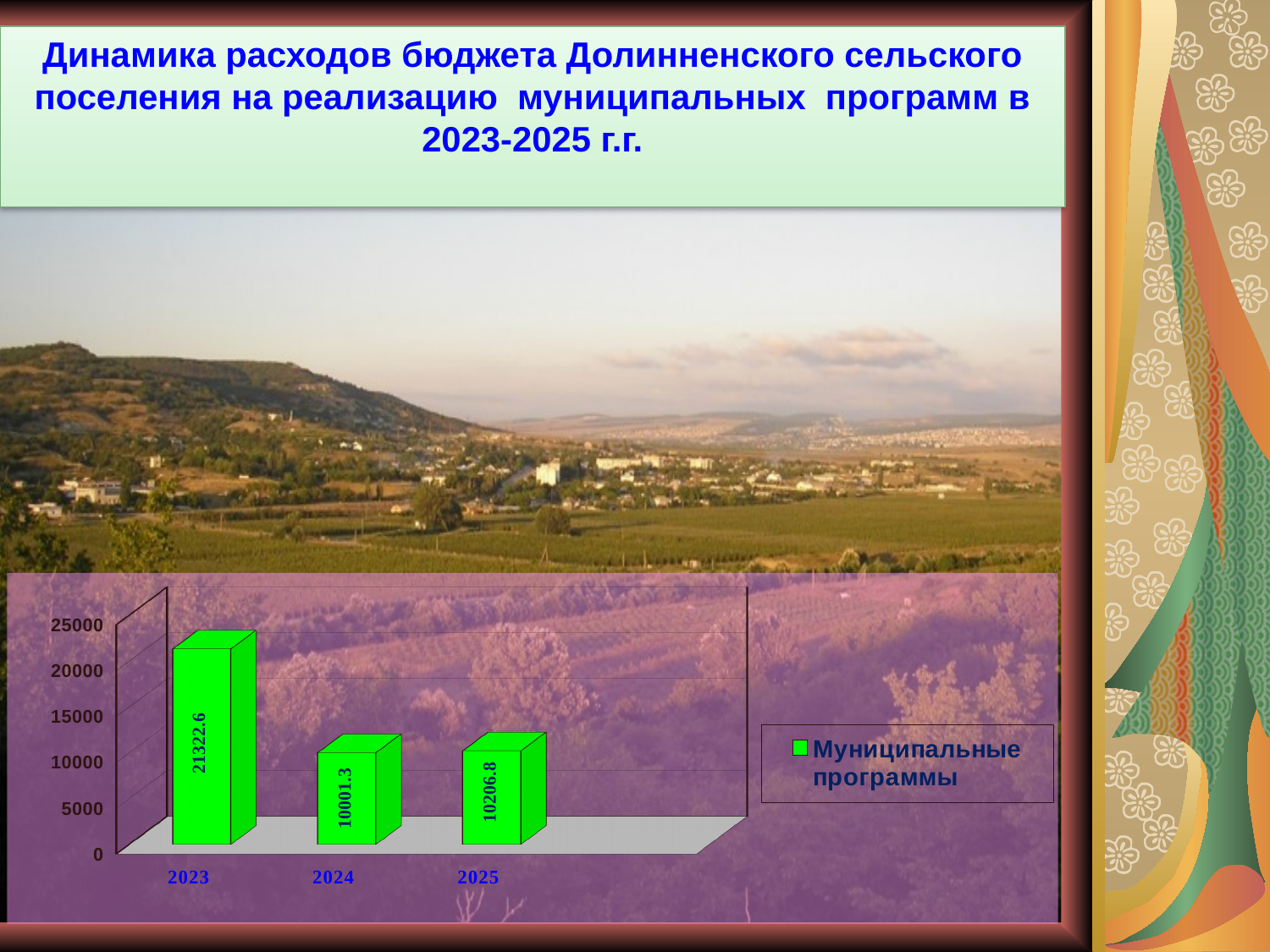
Which year has the lowest value? 2024 Which is larger, the value for 2023 or the value for 2025? 2023 What is the value for 2023? 21322.6 What series name does the legend show? Муниципальные программы What is the value for 2025? 10206.8 How many years are shown on the chart? 3 What kind of chart is shown on the slide? bar chart Is the value for 2023 greater or less than 20000? greater What is the difference between the values for 2025 and 2024? 205.5 What is the value for 2024? 10001.3 Which year has the highest value? 2023 What is the difference between the values for 2023 and 2024? 11321.3